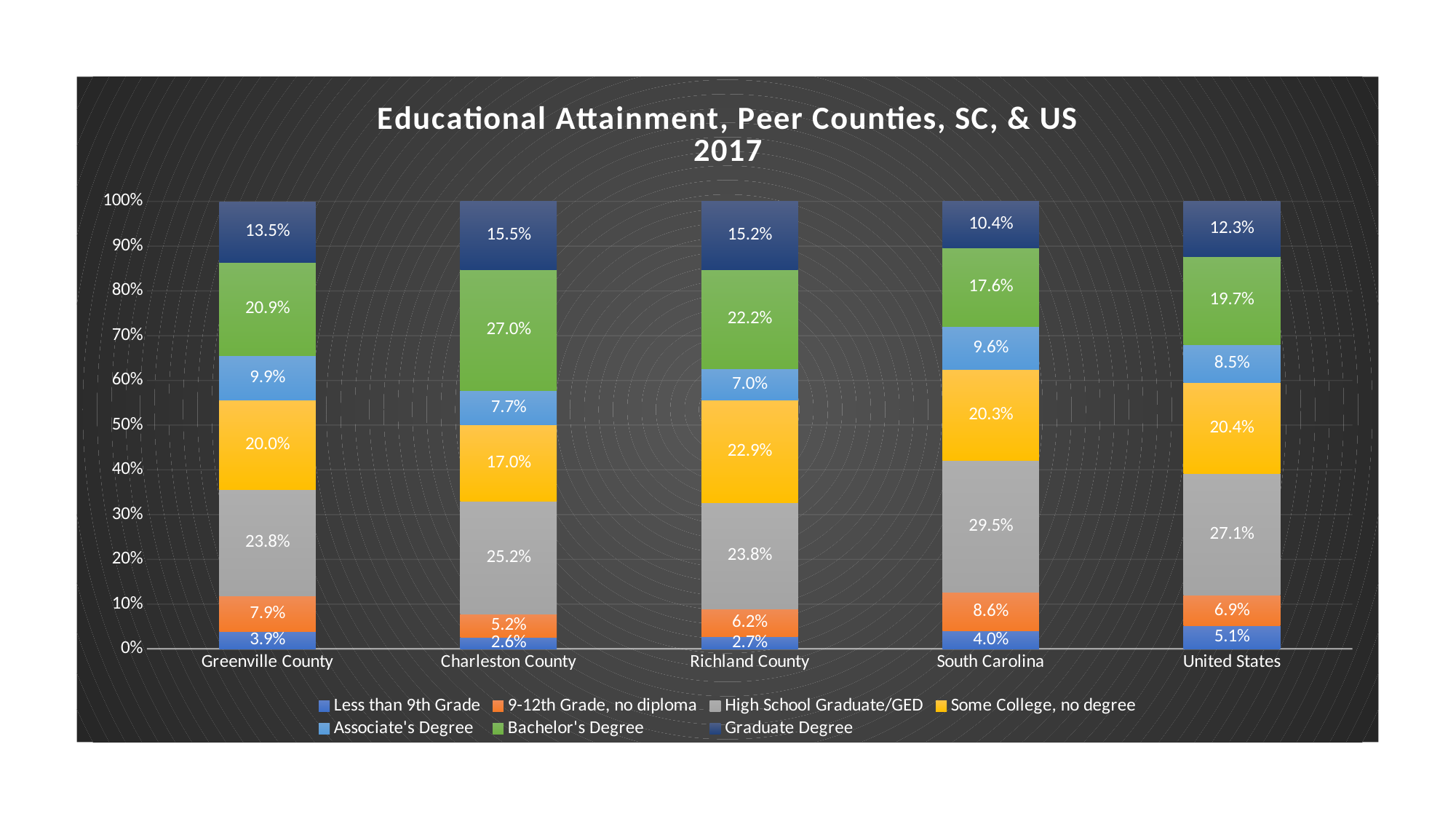
Which category has the lowest Graduate Degree value? South Carolina What kind of chart is shown on the slide? Stacked bar chart What is the Bachelor's Degree value for Charleston County? 27.0% How many series does the legend list? 7 What is the Graduate Degree value for the United States? 12.3% Which has a larger Some College, no degree value: Richland County or Charleston County? Richland County What is the title of the chart? Educational Attainment, Peer Counties, SC, & US 2017 How many categories are shown on the x axis? 5 What is the High School Graduate/GED value for South Carolina? 29.5% What is the difference between the Bachelor's Degree values for Charleston County and South Carolina? 9.4 percentage points What is the Less than 9th Grade value for Richland County? 2.7% Which category has the highest Bachelor's Degree value? Charleston County